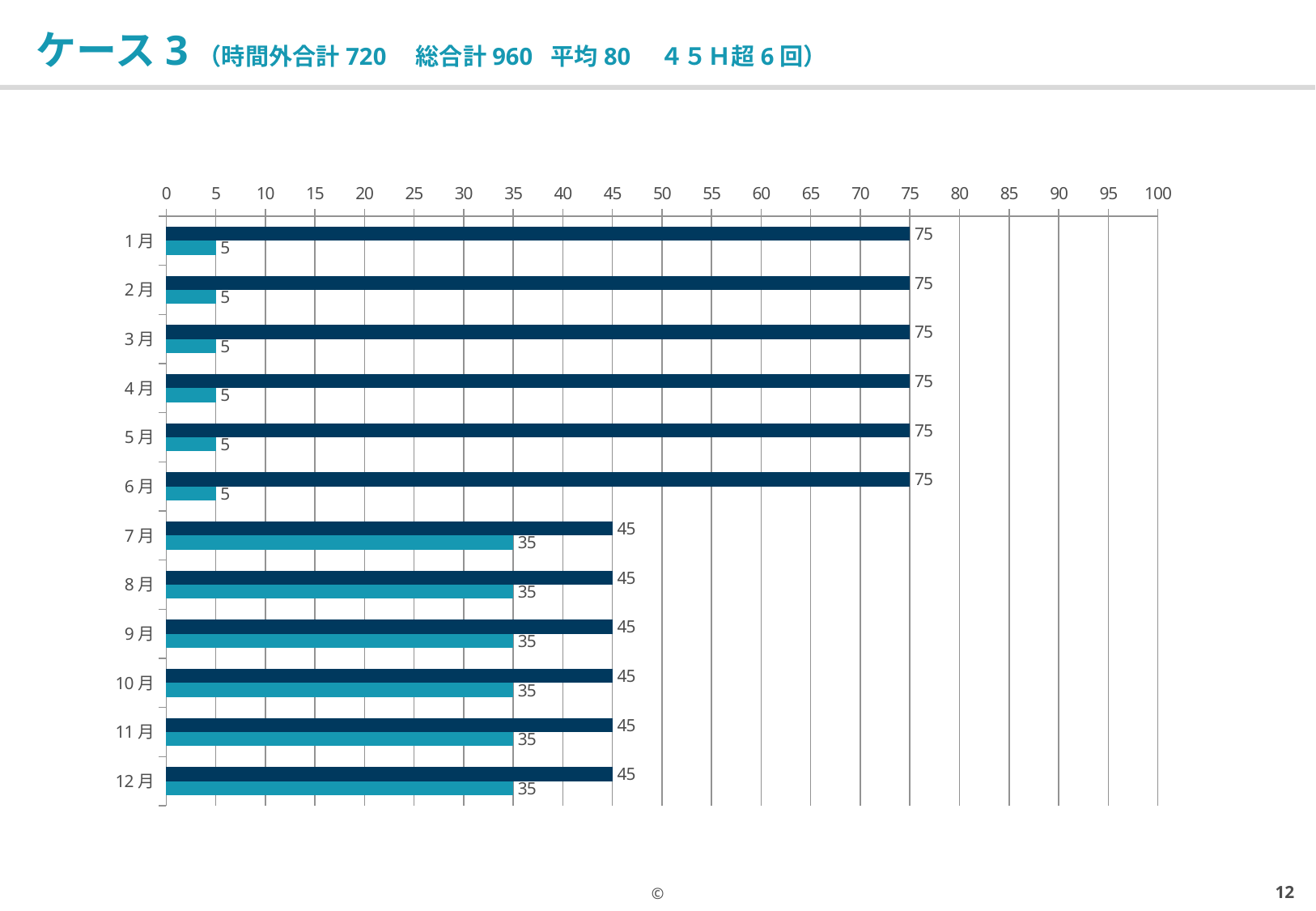
What is the difference between the teal bar for 8月 and the teal bar for 2月? 30 What is the value of the dark navy bar for 9月? 45 What is the value of the dark navy bar for 1月? 75 Which is larger: the dark navy bar for 4月 or the dark navy bar for 10月? 4月 What kind of chart is shown on the slide? bar chart What is the maximum value shown on the horizontal axis of the chart? 100 What is the difference between the dark navy bar for 6月 and the dark navy bar for 7月? 30 Do the dark navy bar values rise or fall from 1月 to 12月? fall What is the value of the teal bar for 3月? 5 How many months (categories) are plotted on the chart? 12 Which is larger: the teal bar for 5月 or the teal bar for 11月? 11月 What is the value of the teal bar for 12月? 35